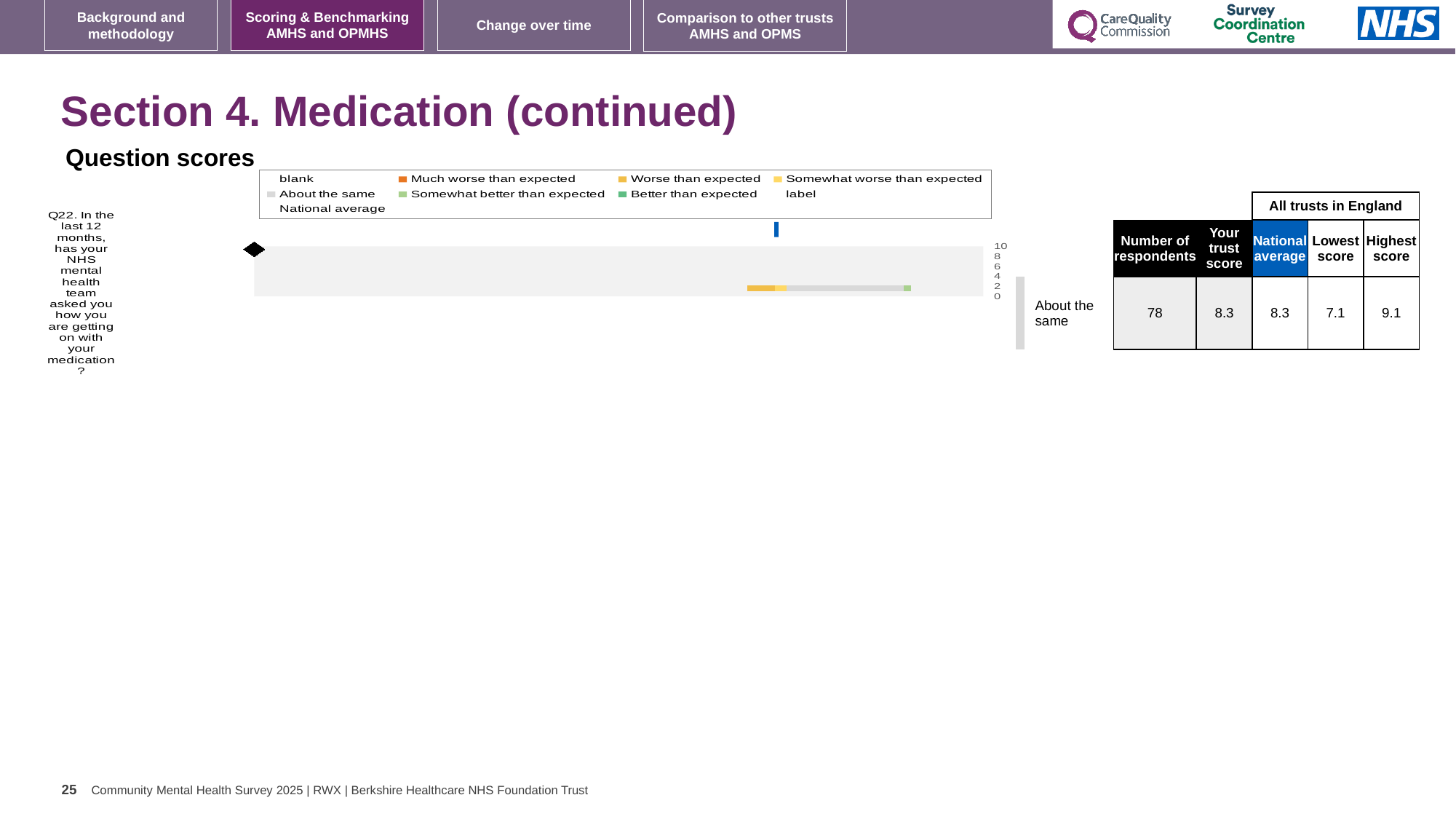
What is the title of the chart on the slide? Question scores What is the highest score among all trusts in England for Q22? 9.1 How many entries does the legend of the 'Question scores' chart list? 9 What kind of chart is shown under 'Question scores'? bar chart What benchmark category is shown for Q22 next to the chart? About the same What colour does the legend use for 'Better than expected'? green What is the difference between the highest score and the lowest score for Q22? 2.0 What is the trust score for Q22 shown in the table beside the chart? 8.3 Is the trust score for Q22 higher than, lower than, or the same as the national average? the same How many questions are plotted in the 'Question scores' chart? 1 What is the national average for Q22 shown in the table beside the chart? 8.3 What is the number of respondents for Q22? 78